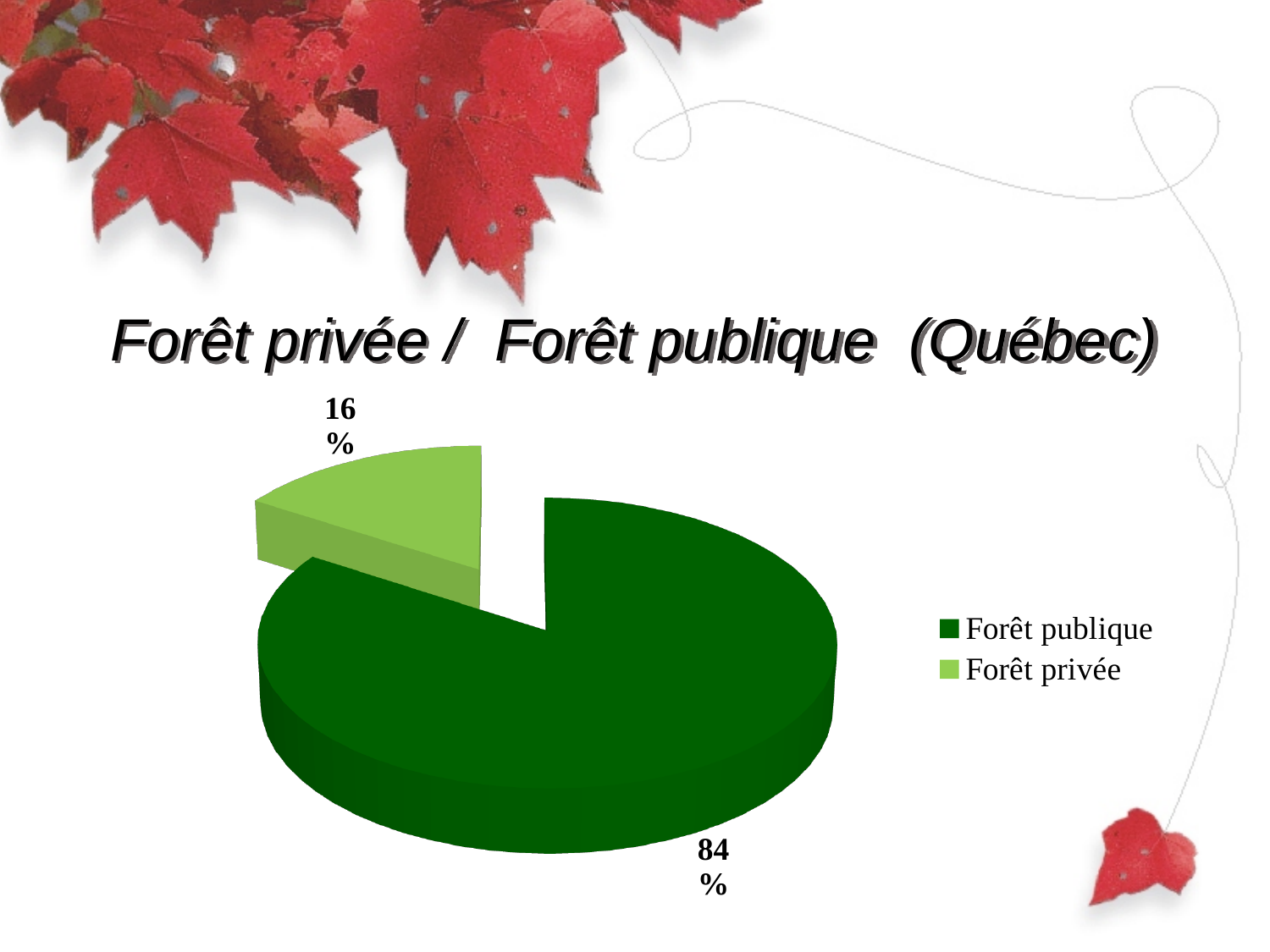
Which category has the smallest slice of the pie? Forêt privée What is the title of the slide? Forêt privée / Forêt publique (Québec) How many slices does the pie chart have? 2 What is the difference in percentage points between Forêt publique and Forêt privée? 68 What share of the pie does Forêt privée represent? 16% Which is larger, the slice for Forêt publique or the slice for Forêt privée? Forêt publique What kind of chart is shown on the slide? Pie chart Which legend entry is shown in dark green? Forêt publique How many entries does the legend list? 2 Which category has the largest slice of the pie? Forêt publique What share of the pie does Forêt publique represent? 84%